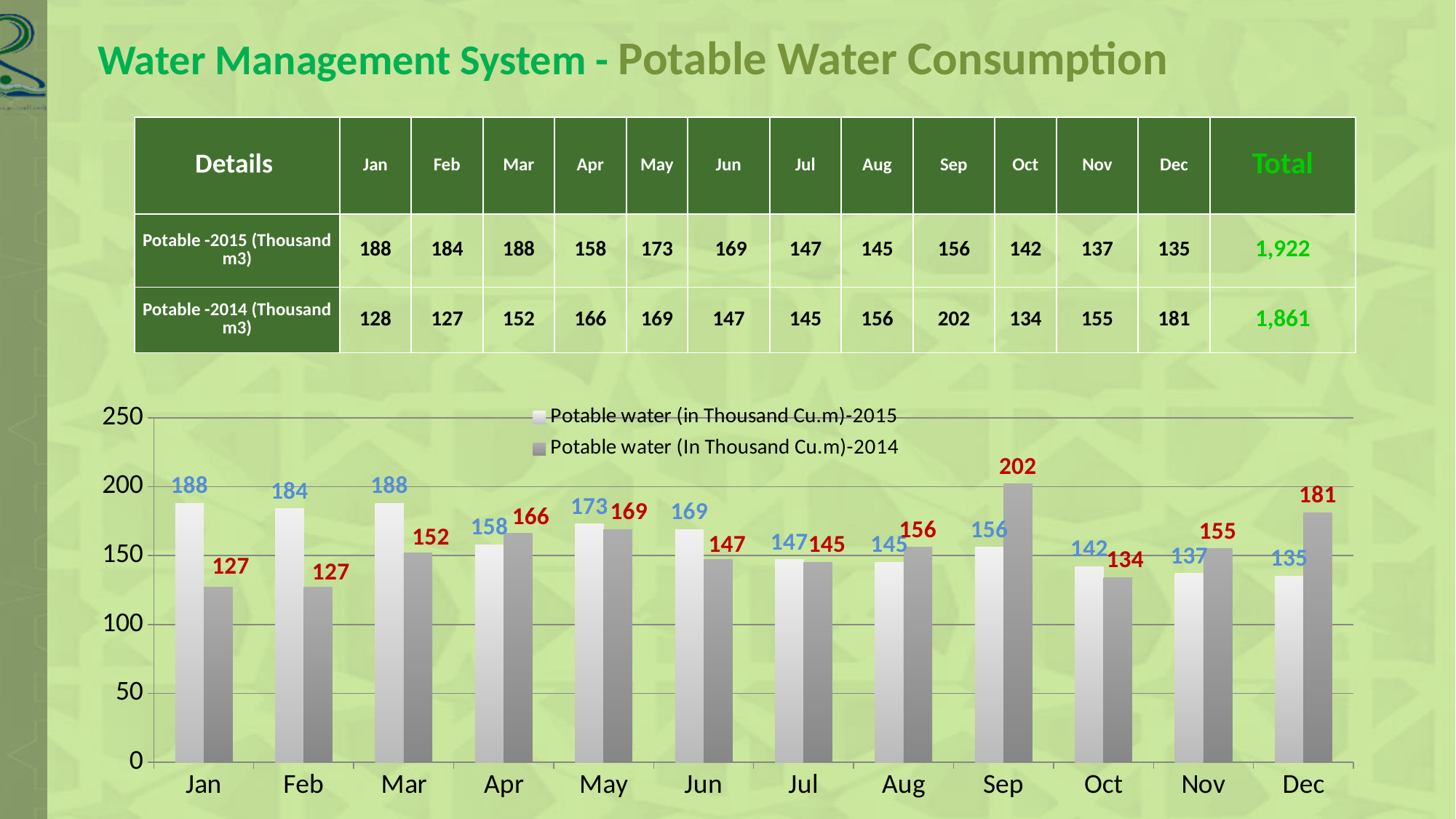
Which month has the lowest 2015 potable water value in the chart? Dec In the chart, what is the difference between the 2014 and 2015 potable water values for Dec? 46 How many series does the chart legend list? 2 What is the 2014 potable water value for Sep in the chart? 202 Which month has the highest 2014 potable water value in the chart? Sep In the chart, which series has the larger value for Apr, 2015 or 2014? 2014 What is the 2015 potable water value for Mar in the chart? 188 Which series does the lighter (white-grey) bar represent in the chart legend? Potable water (in Thousand Cu.m)-2015 What kind of chart is shown on the slide? bar chart How many months are shown along the x axis of the chart? 12 What is the 2015 potable water value for Oct in the chart? 142 Does the 2015 potable water series generally rise or fall from Jan to Dec in the chart? fall